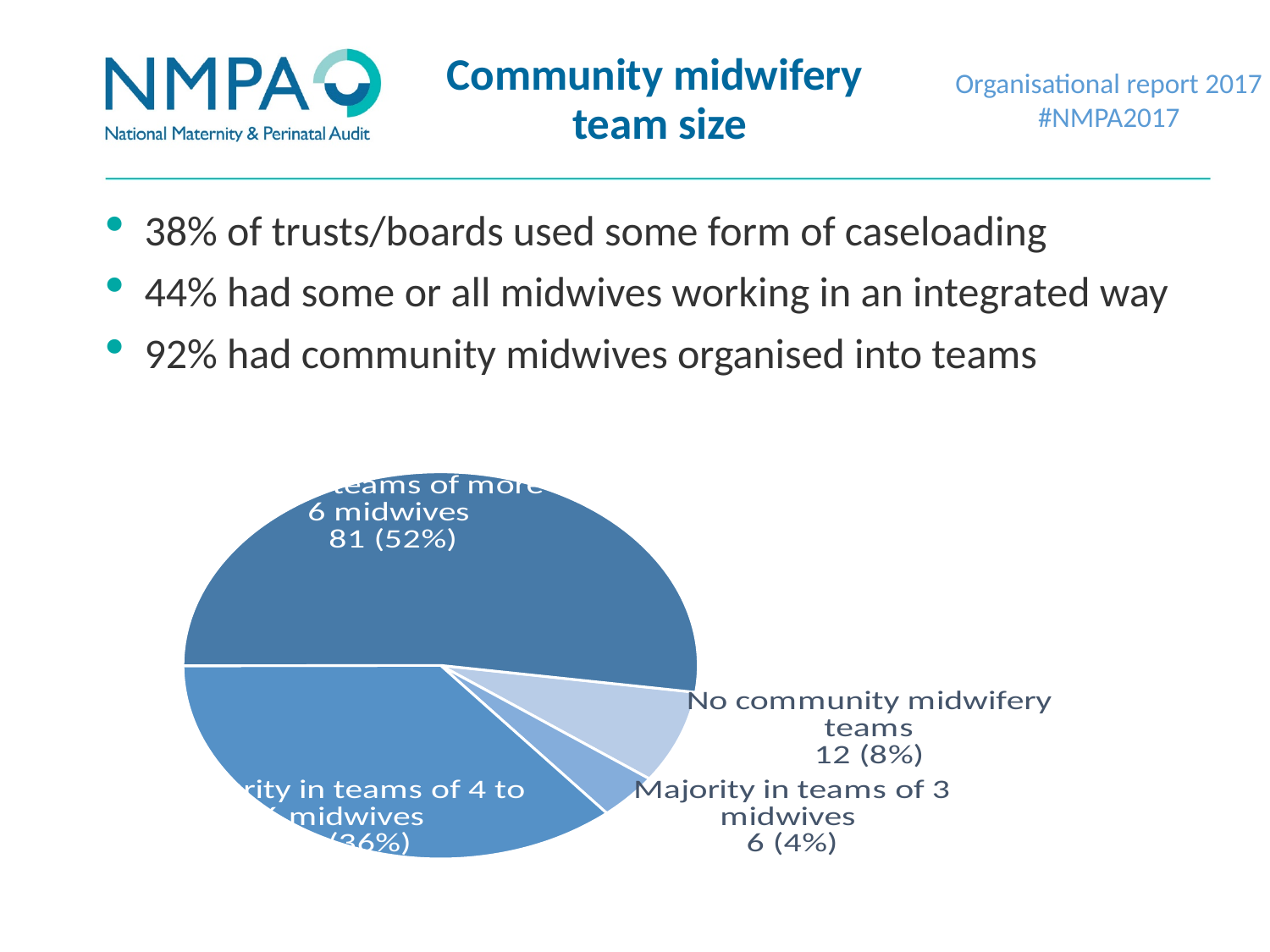
What share of the pie is 'Majority in teams of 3 midwives'? 4% How many slices does the pie chart have? 4 What value is shown for the 'No community midwifery teams' slice? 12 (8%) Which slice of the pie chart is the smallest? Majority in teams of 3 midwives Which is larger: 'No community midwifery teams' or 'Majority in teams of 3 midwives'? No community midwifery teams What kind of chart is shown on the slide? pie chart What value is shown for the 'Majority in teams of 3 midwives' slice? 6 (4%) What share of the pie is 'No community midwifery teams'? 8% Which slice of the pie chart is shown in the lightest colour? No community midwifery teams What value is printed on the largest slice of the pie chart? 81 (52%) What is the difference in count between 'No community midwifery teams' and 'Majority in teams of 3 midwives'? 6 What percentage is shown for the slice for majority in teams of 4 to 6 midwives? 36%